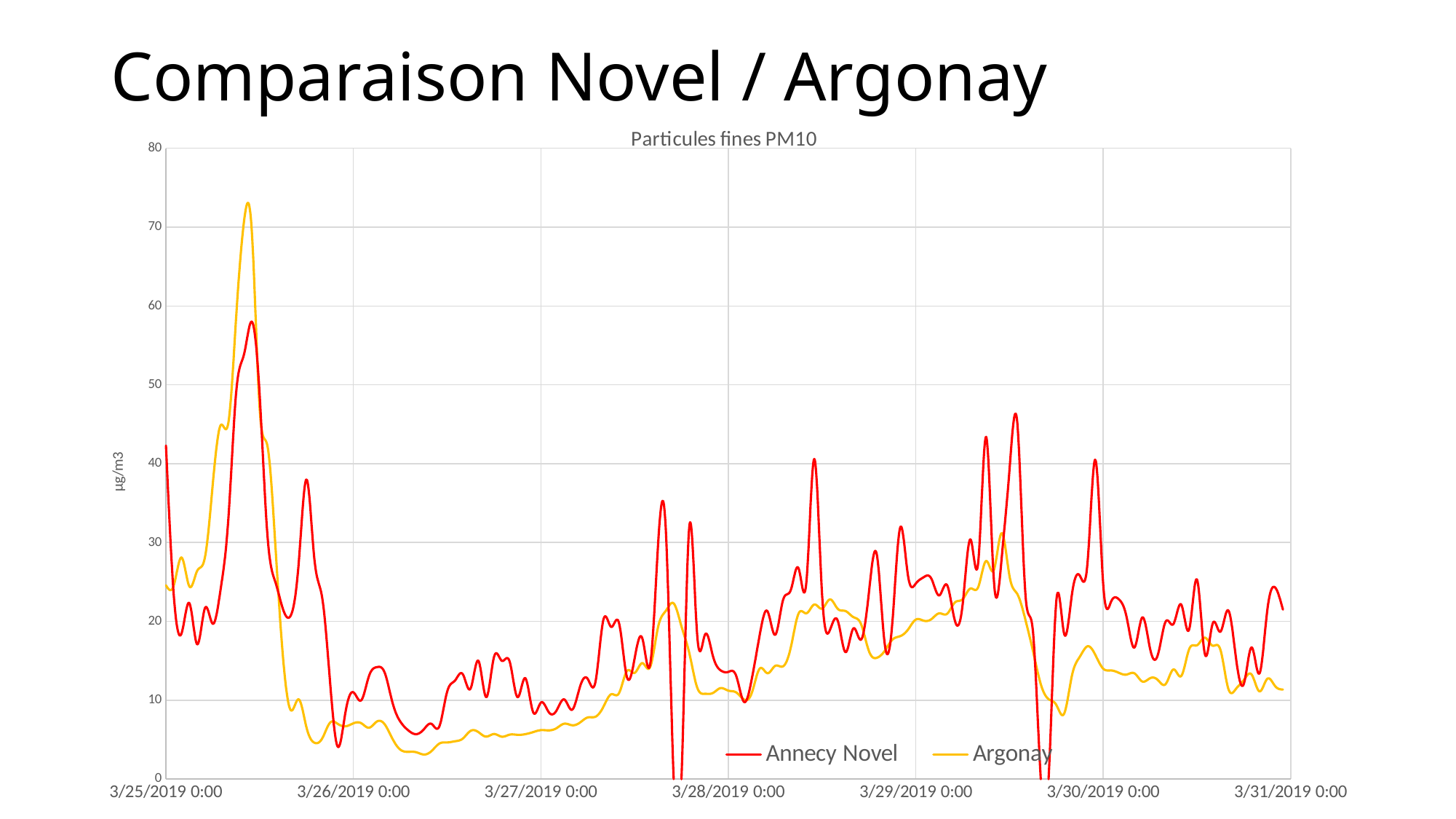
Around 3/26/2019 0:00, which series has the higher value, Annecy Novel or Argonay? Annecy Novel Which series reaches the highest peak on the chart? Argonay How many date labels are shown along the horizontal axis? 7 How many series does the legend list? 2 Is the highest value of the Annecy Novel series greater or less than 50? greater What is the first date shown on the horizontal axis? 3/25/2019 0:00 What is the title of the chart? Particules fines PM10 What unit is shown on the vertical axis? µg/m3 Is the Argonay value at 3/27/2019 0:00 greater or less than 10? less What kind of chart is shown on the slide? Line chart Is the highest value of the Annecy Novel series greater or less than 60? less